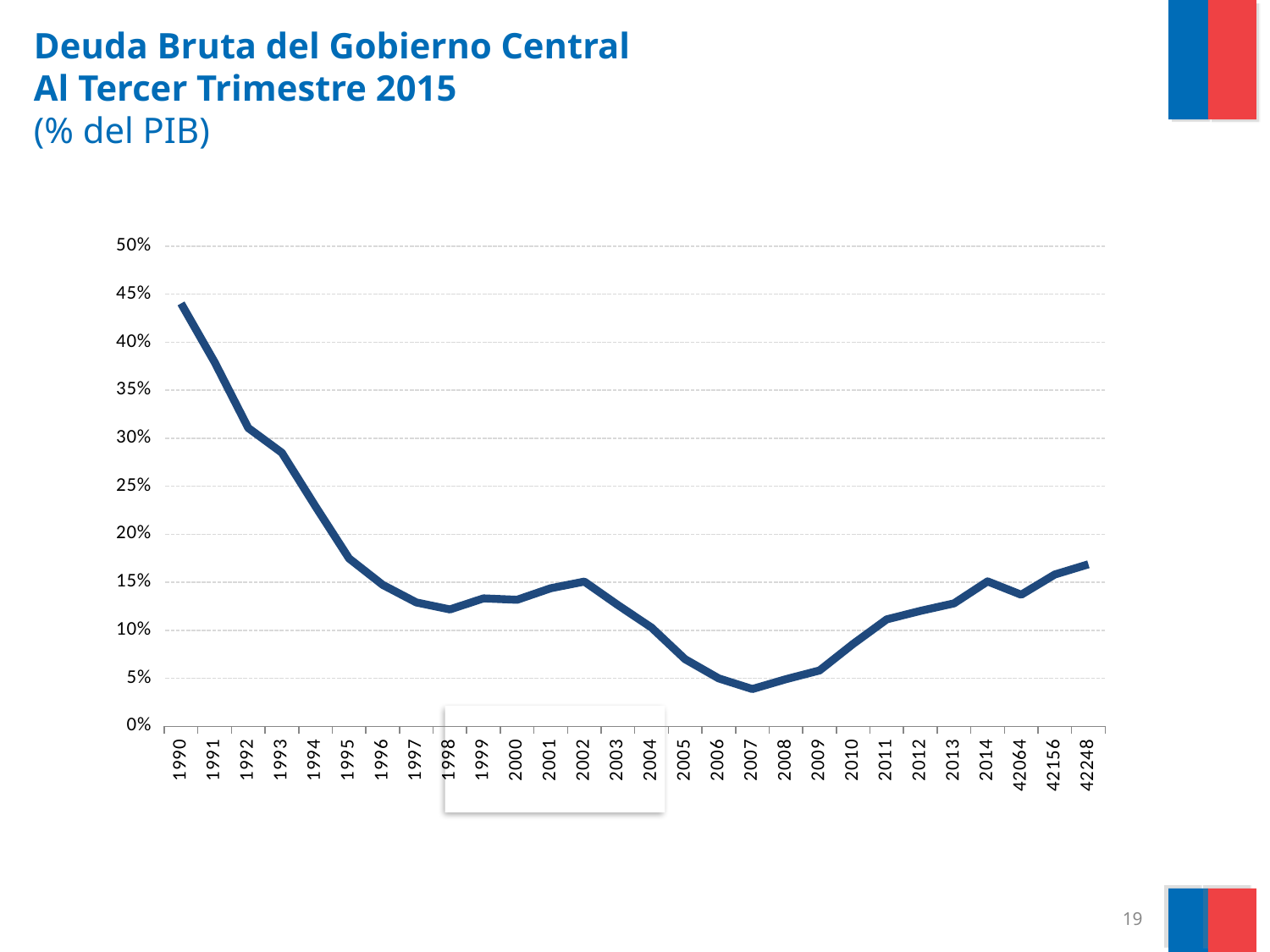
Is the value for 1993 greater or less than 30%? less Which year has the lowest value on the chart? 2007 Which is larger, the value for 1992 or the value for 2002? 1992 In what unit are the values on the chart expressed, according to the slide title? % del PIB Do the values rise or fall from 1990 to 2007? fall Which is larger, the value for 2007 or the value for 2014? 2014 Is the value for 1990 greater or less than 40%? greater Is the value for 1995 greater or less than 20%? less Which year has the highest value on the chart? 1990 What kind of chart is shown on the slide? line chart